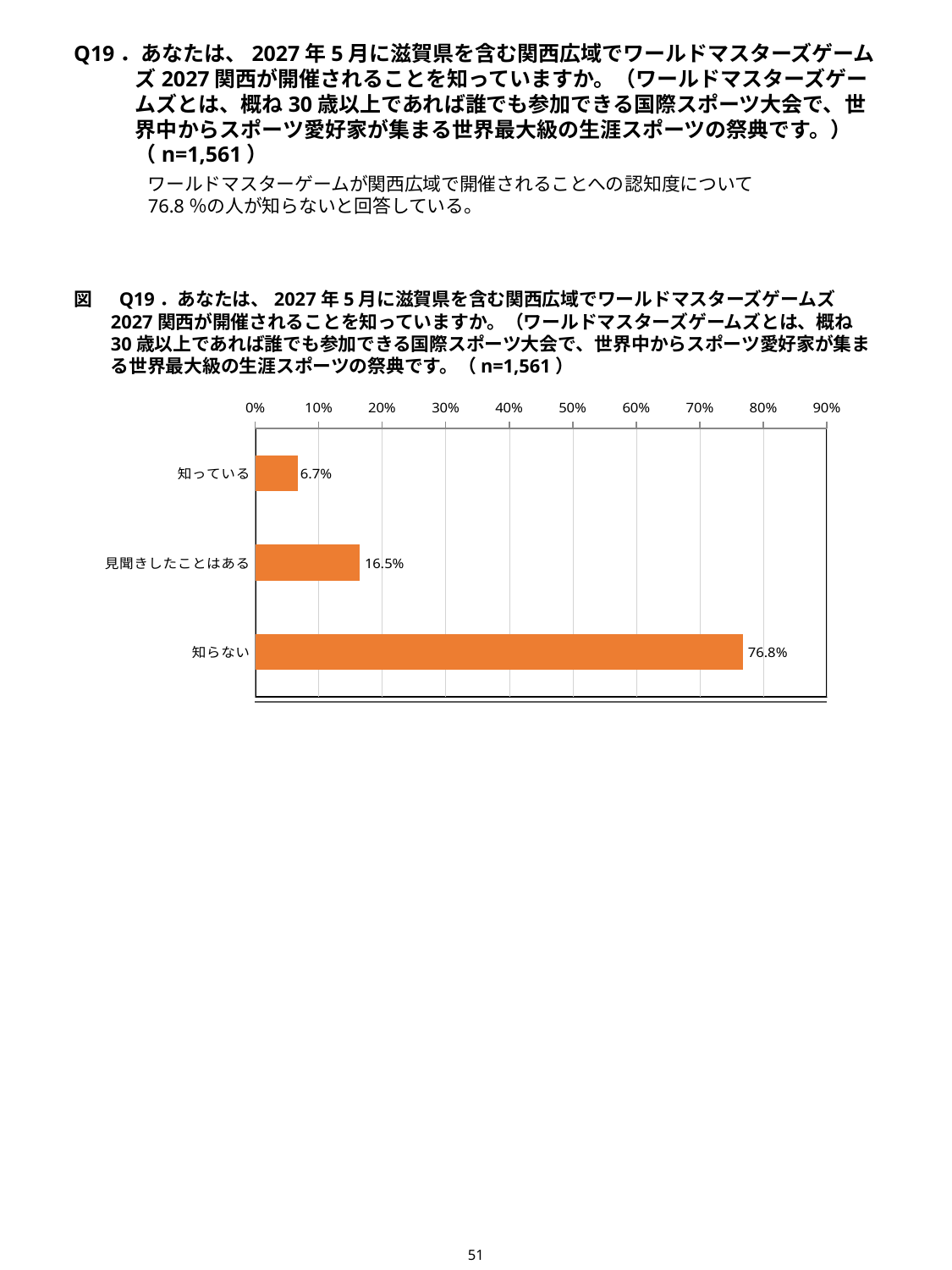
Which category has the lowest value? 知っている How many categories are shown in the chart? 3 Which is larger, the value for 知っている or the value for 見聞きしたことはある? 見聞きしたことはある Which category has the highest value? 知らない What kind of chart is shown on the slide? bar chart Is the value for 知らない greater or less than 70%? greater What is the value for 知らない? 76.8% What is the sample size (n) stated in the chart title? 1,561 What is the value for 知っている? 6.7% What is the difference between the values for 知らない and 見聞きしたことはある? 60.3% What is the difference between the values for 見聞きしたことはある and 知っている? 9.8% What is the value for 見聞きしたことはある? 16.5%